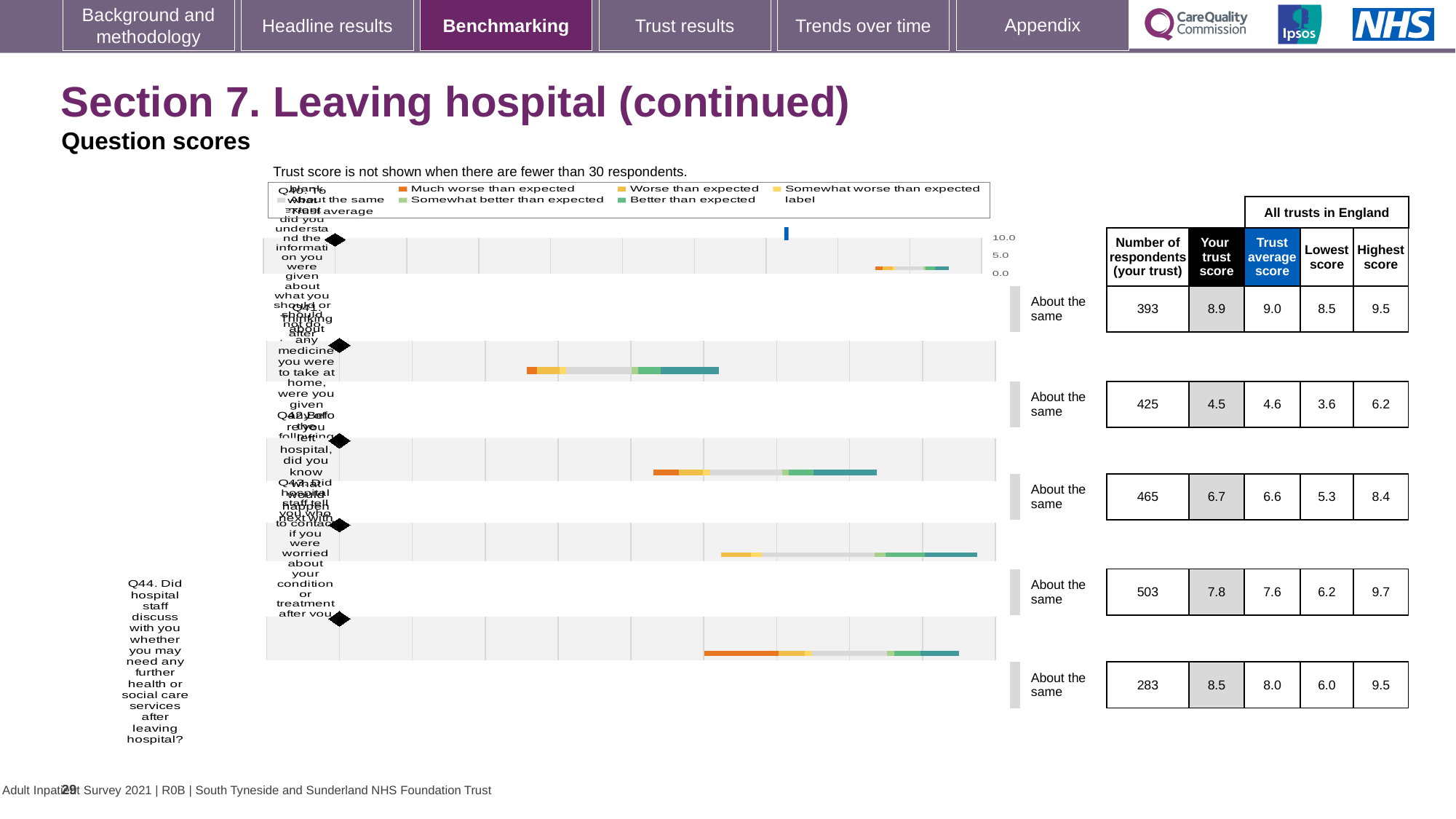
How many respondents from your trust answered Q44? 283 Which question has the lowest 'Your trust score' in the table? Q41 How many questions are plotted in the chart? 5 What is the 'Lowest score' across all trusts in England for Q41? 3.6 What is the 'Your trust score' value for Q44 (Did hospital staff discuss with you whether you may need any further health or social care services after leaving hospital?)? 8.5 Which question has the highest 'Your trust score' in the table? Q40 What is the difference between 'Your trust score' and 'Trust average score' for Q44? 0.5 Is the 'Your trust score' for Q41 greater or less than 5.0? less For Q42, which is larger: 'Your trust score' or 'Trust average score'? Your trust score What benchmark category is shown for Q44? About the same What is the 'Highest score' across all trusts in England for Q43? 9.7 What kind of chart is used to show the question scores? Bar chart